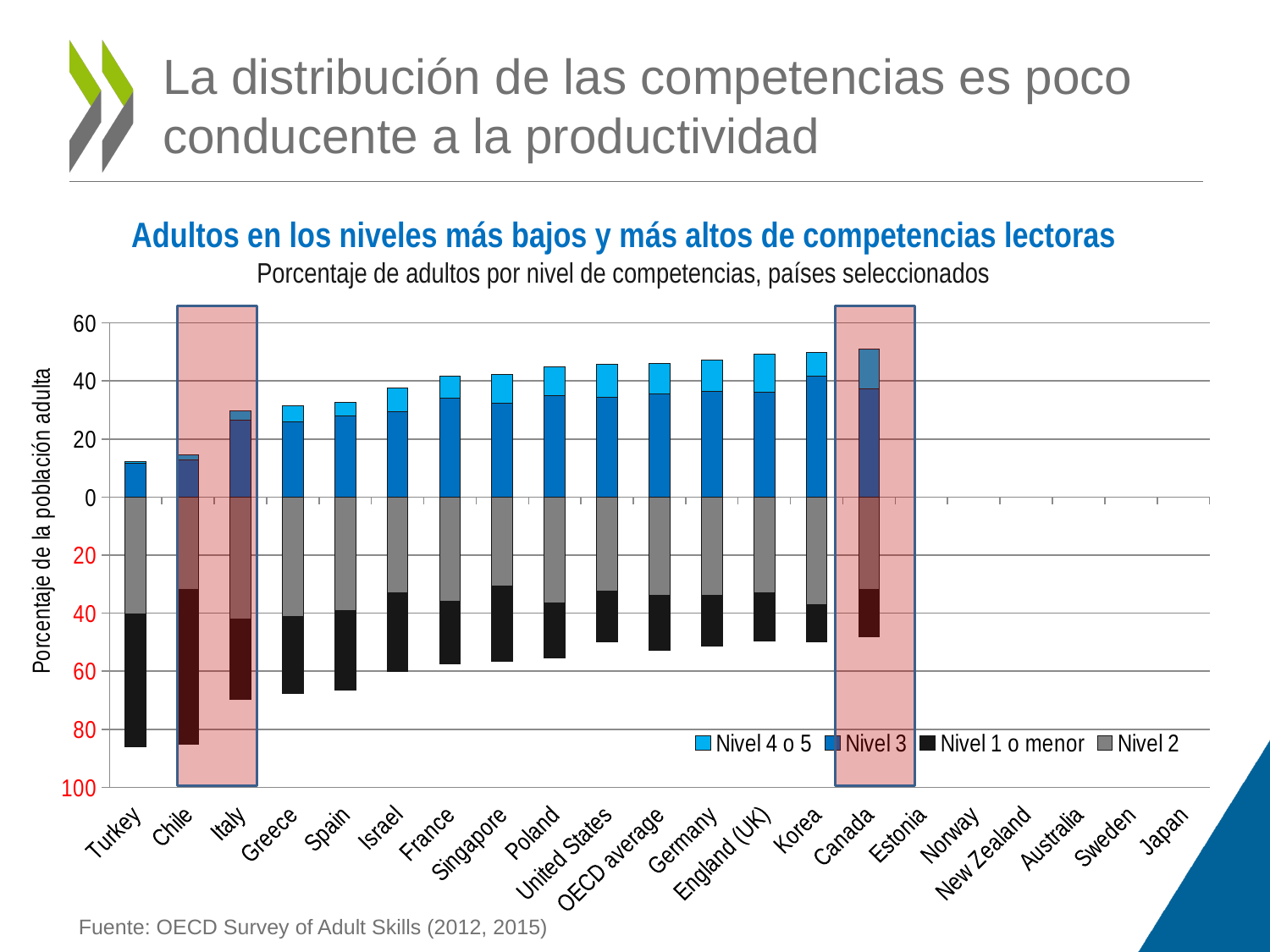
What is the label on the vertical axis of the chart? Porcentaje de la población adulta Which has a larger combined share of adults at Nivel 1 o menor and Nivel 2, Chile or Korea? Chile Is the combined value below zero (Nivel 1 o menor plus Nivel 2) for Chile greater or less than 80? greater What kind of chart is shown on the slide? Stacked bar chart Which has a larger combined share of adults at Nivel 3 and Nivel 4 o 5, Turkey or Canada? Canada How many series does the legend list? 4 Do the bars above zero (Nivel 3 plus Nivel 4 o 5) generally rise or fall from Turkey to Canada along the x axis? rise Is the combined value below zero (Nivel 1 o menor plus Nivel 2) for Greece greater or less than 60? greater How many category labels are shown along the x axis? 21 Is the combined value above zero (Nivel 3 plus Nivel 4 o 5) for Turkey greater or less than 20? less Which country has the lowest combined share of adults at Nivel 3 and Nivel 4 o 5 (the bars above zero)? Turkey